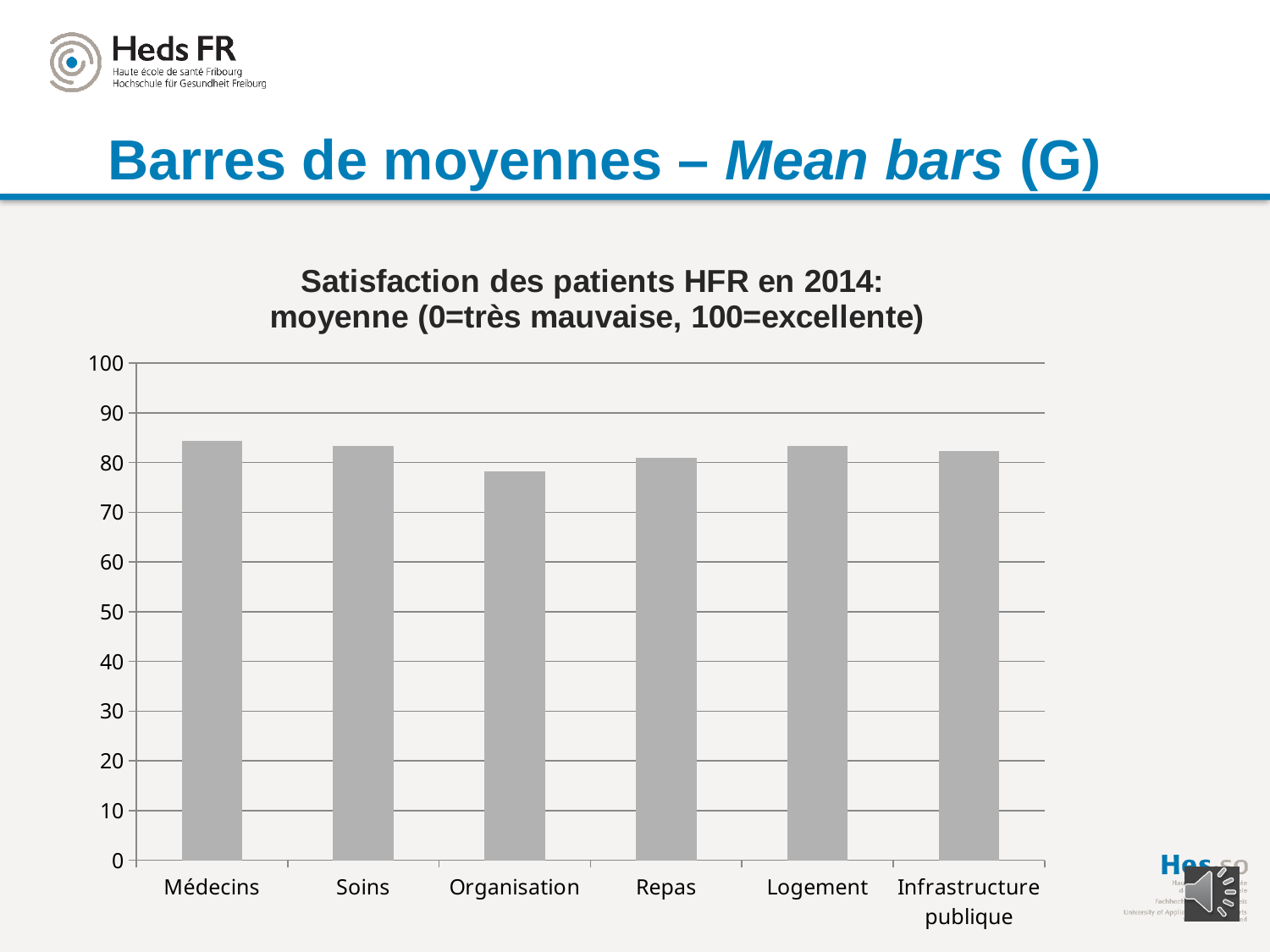
Is the value for Médecins greater or less than 80? greater Is the value for Logement greater or less than 70? greater What is the title of the chart? Satisfaction des patients HFR en 2014: moyenne (0=très mauvaise, 100=excellente) What kind of chart is shown on the slide? bar chart Is the value for Infrastructure publique greater or less than 80? greater Which has the larger value, Repas or Organisation? Repas What is the maximum value shown on the y axis of the chart? 100 How many categories are shown on the x axis of the chart? 6 Which category has the lowest mean satisfaction score? Organisation Which has the larger value, Médecins or Organisation? Médecins